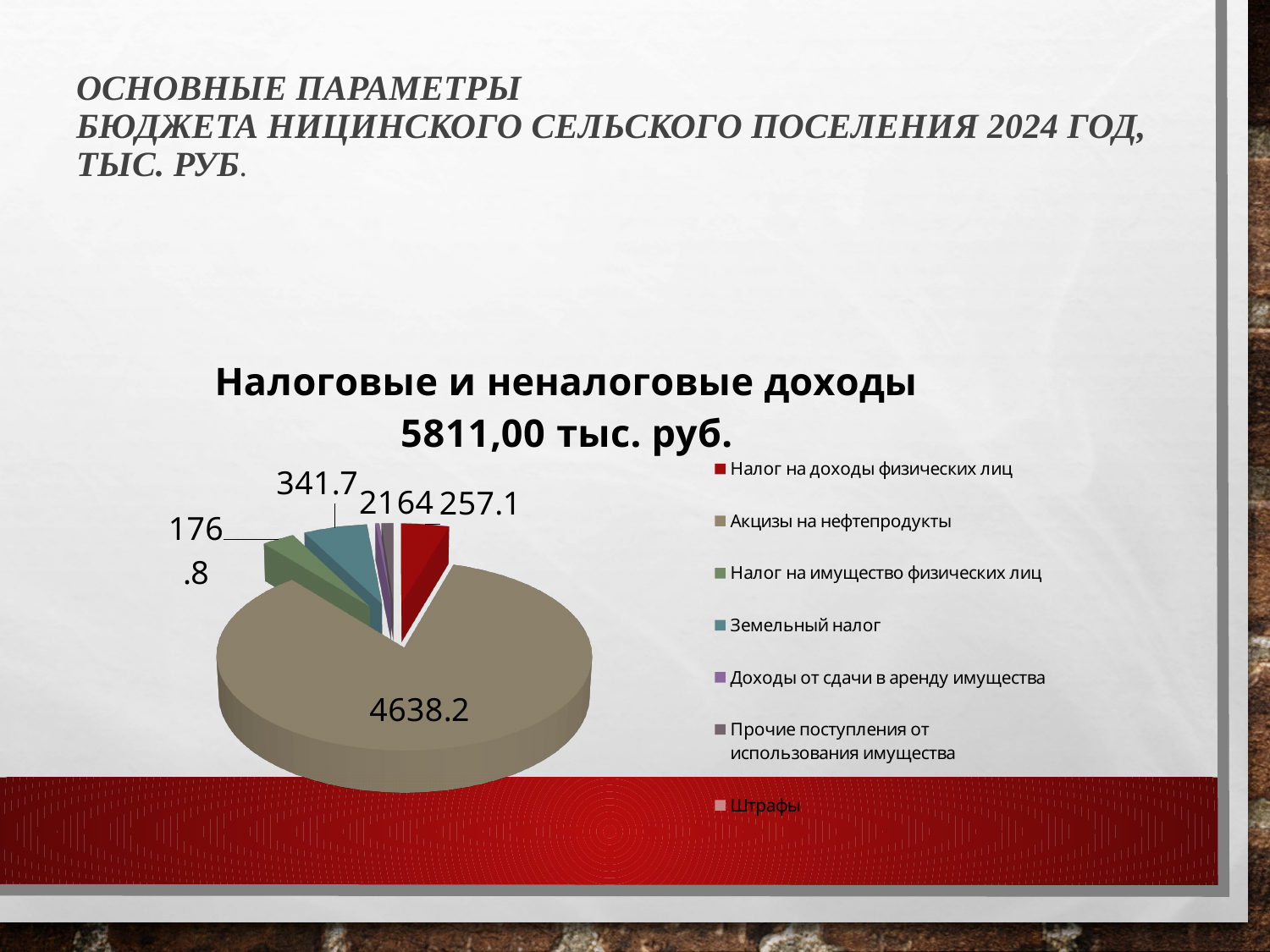
Which is larger, Налог на доходы физических лиц or Земельный налог? Земельный налог What is the value for Налог на доходы физических лиц? 257.1 What is the title of the chart? Налоговые и неналоговые доходы 5811,00 тыс. руб. Which is larger, Земельный налог or Налог на имущество физических лиц? Земельный налог What is the value for Налог на имущество физических лиц? 176.8 What is the value for Акцизы на нефтепродукты? 4638.2 Which category has the largest slice of the pie? Акцизы на нефтепродукты What is the difference between Акцизы на нефтепродукты and Налог на доходы физических лиц? 4381.1 How many categories does the legend of the pie chart list? 7 What is the value for Земельный налог? 341.7 What kind of chart is shown on the slide? pie chart What is the difference between Земельный налог and Налог на имущество физических лиц? 164.9